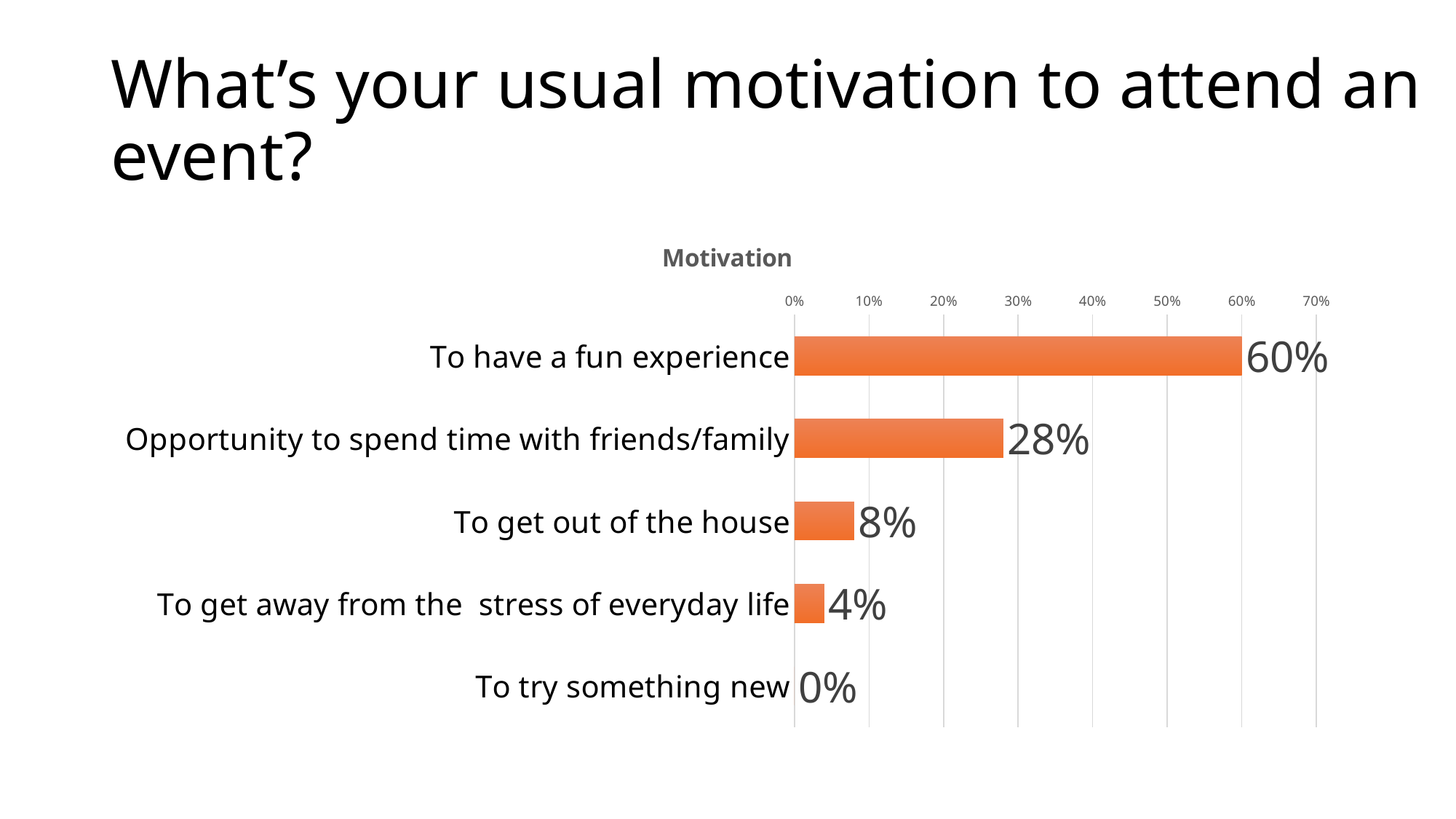
Which motivation has the lowest value? To try something new Which motivation has the highest value? To have a fun experience What is the title of the chart? Motivation Which is larger: "To get out of the house" or "To get away from the stress of everyday life"? To get out of the house What is the value for "To get out of the house"? 8% What is the value for "Opportunity to spend time with friends/family"? 28% What is the difference between "To have a fun experience" and "Opportunity to spend time with friends/family"? 32% What is the value for "To try something new"? 0% How many motivation categories are shown in the chart? 5 What percentage of respondents chose "To have a fun experience" as their usual motivation? 60% What is the value for "To get away from the stress of everyday life"? 4% What kind of chart is shown on the slide? Bar chart